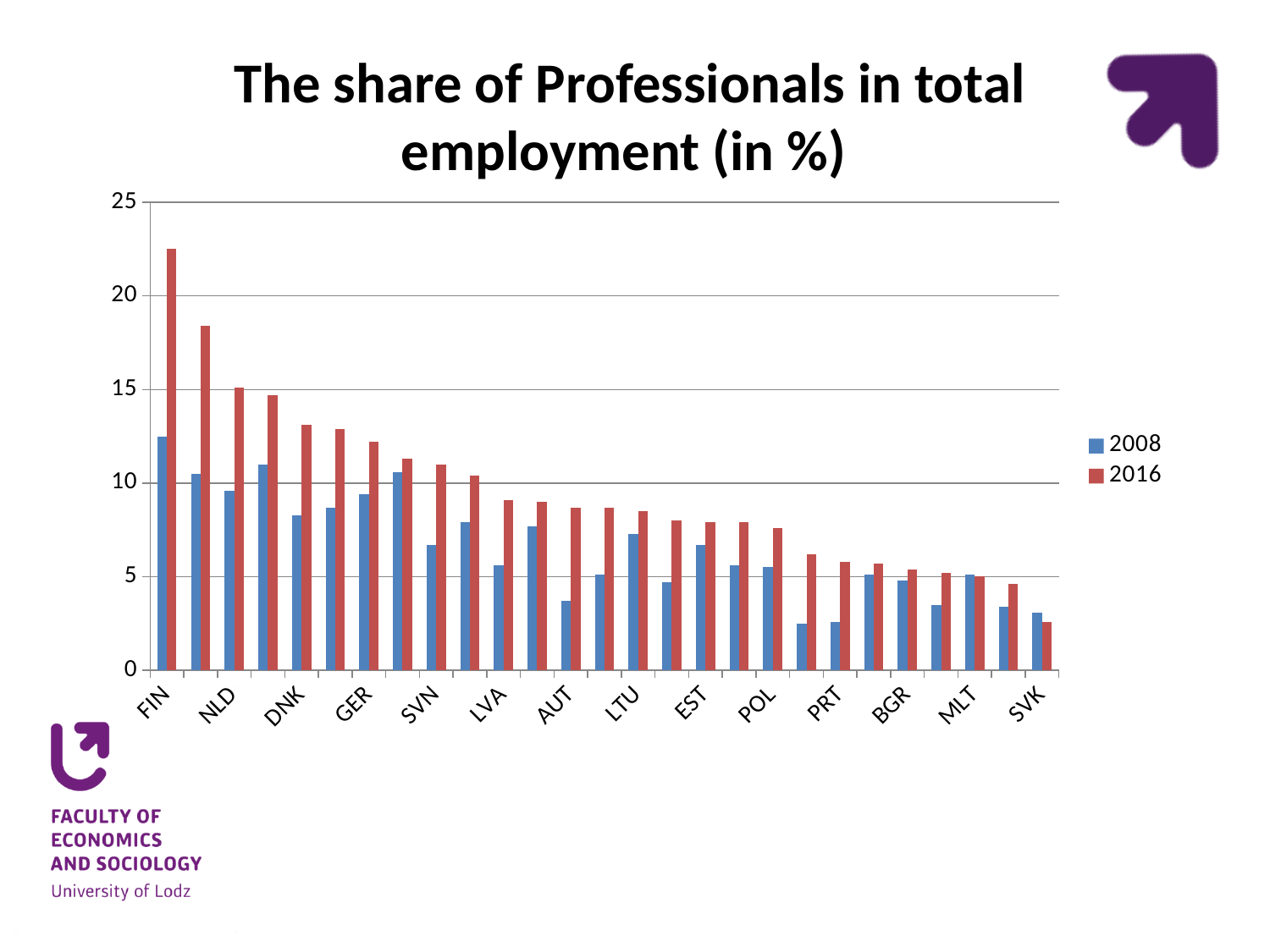
Do the 2016 values generally rise or fall from left to right along the x axis? fall Which country has the highest 2016 value? FIN Is the 2016 value for FIN greater or less than 20? greater Is the 2016 value for SVK greater or less than 5? less For AUT, which year has the larger value, 2008 or 2016? 2016 Is the 2016 value for DNK greater or less than 10? greater What kind of chart is shown on the slide? bar chart How many series does the legend list? 2 Which series are listed in the legend? 2008 and 2016 Which is larger, the 2016 value for FIN or the 2016 value for NLD? FIN